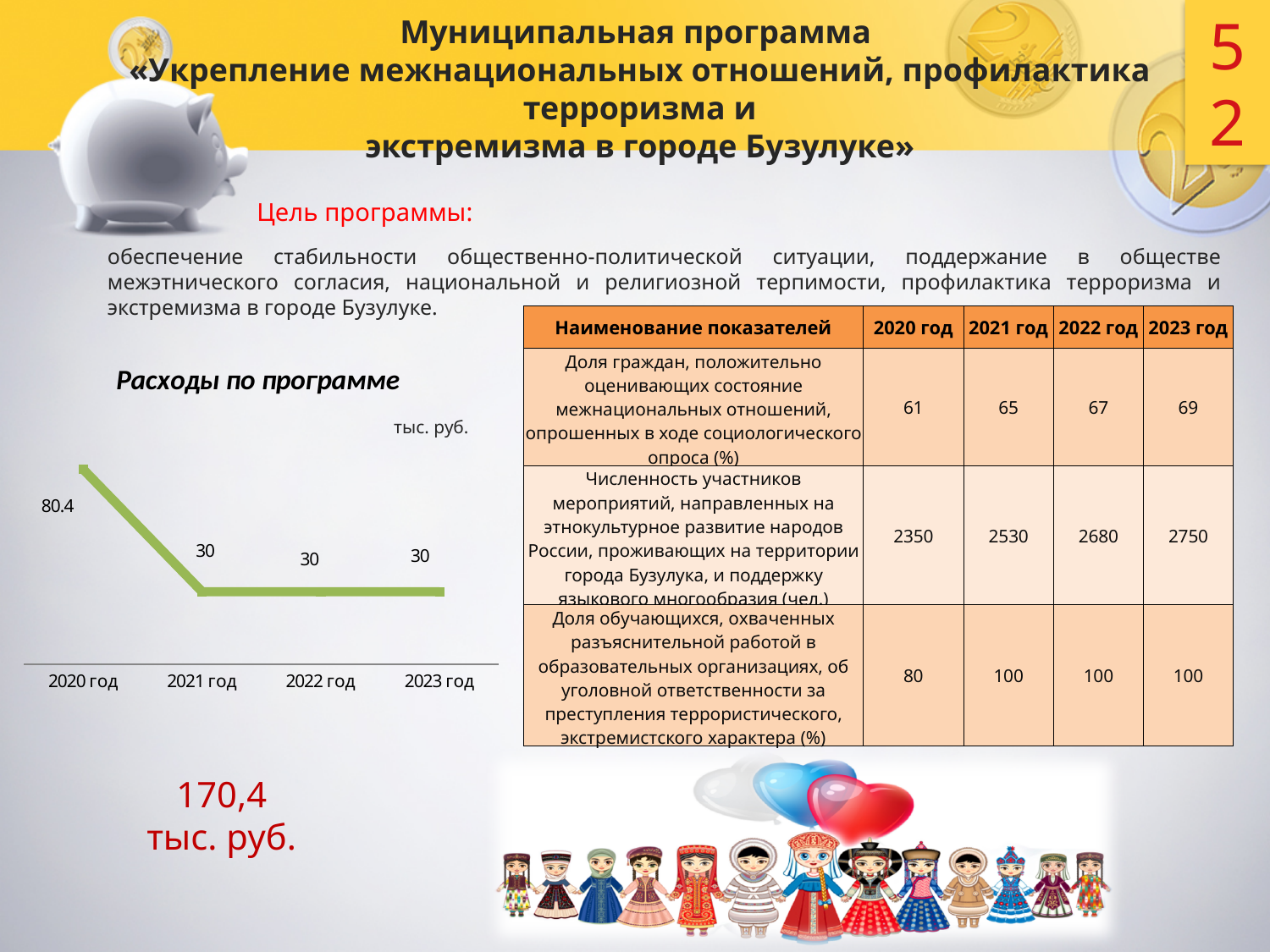
In the 'Расходы по программе' chart, which is larger: the value for 2020 год or the value for 2022 год? 2020 год What is the value for 2021 год in the 'Расходы по программе' chart? 30 What unit is indicated for the values in the 'Расходы по программе' chart? тыс. руб. What is the title of the line chart on the slide? Расходы по программе Which year has the highest value in the 'Расходы по программе' chart? 2020 год What is the value for 2023 год in the 'Расходы по программе' chart? 30 What is the difference between the values for 2020 год and 2021 год in the 'Расходы по программе' chart? 50.4 How many years (data points) are shown in the 'Расходы по программе' chart? 4 Do the values in the 'Расходы по программе' chart rise or fall from 2020 год to 2021 год? fall What type of chart is used to show 'Расходы по программе'? line chart Do the values in the 'Расходы по программе' chart change between 2021 год and 2023 год? No, they stay at 30 What is the value for 2020 год in the 'Расходы по программе' chart? 80.4